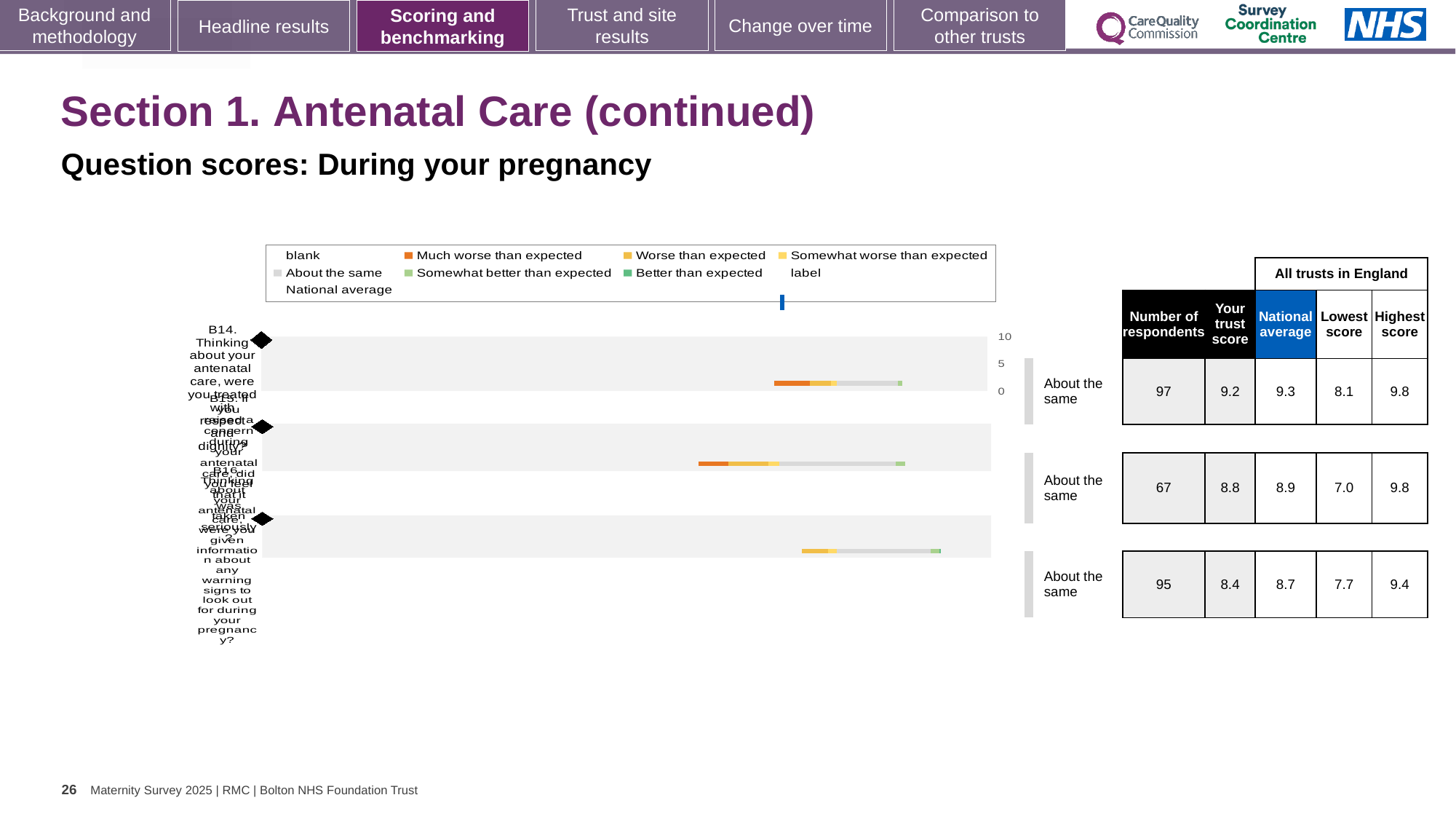
What is the national average for the second question row? 8.9 What is the highest value shown on the chart's numeric axis? 10 Which legend entry is shown in dark orange? Much worse than expected Which question row has the lowest number of respondents? second row (67) How many question rows (bars) are plotted in the chart? 3 What is the trust score for the first question row (B14)? 9.2 Which question row has the highest trust score? B14 (first row) What kind of chart is shown on the slide? bar chart What is the difference between the national average and the trust score for the third question row? 0.3 What benchmark category is given for all three question rows? About the same What is the number of respondents for the first question row (B14)? 97 What is the lowest score among all trusts in England for the third question row? 7.7